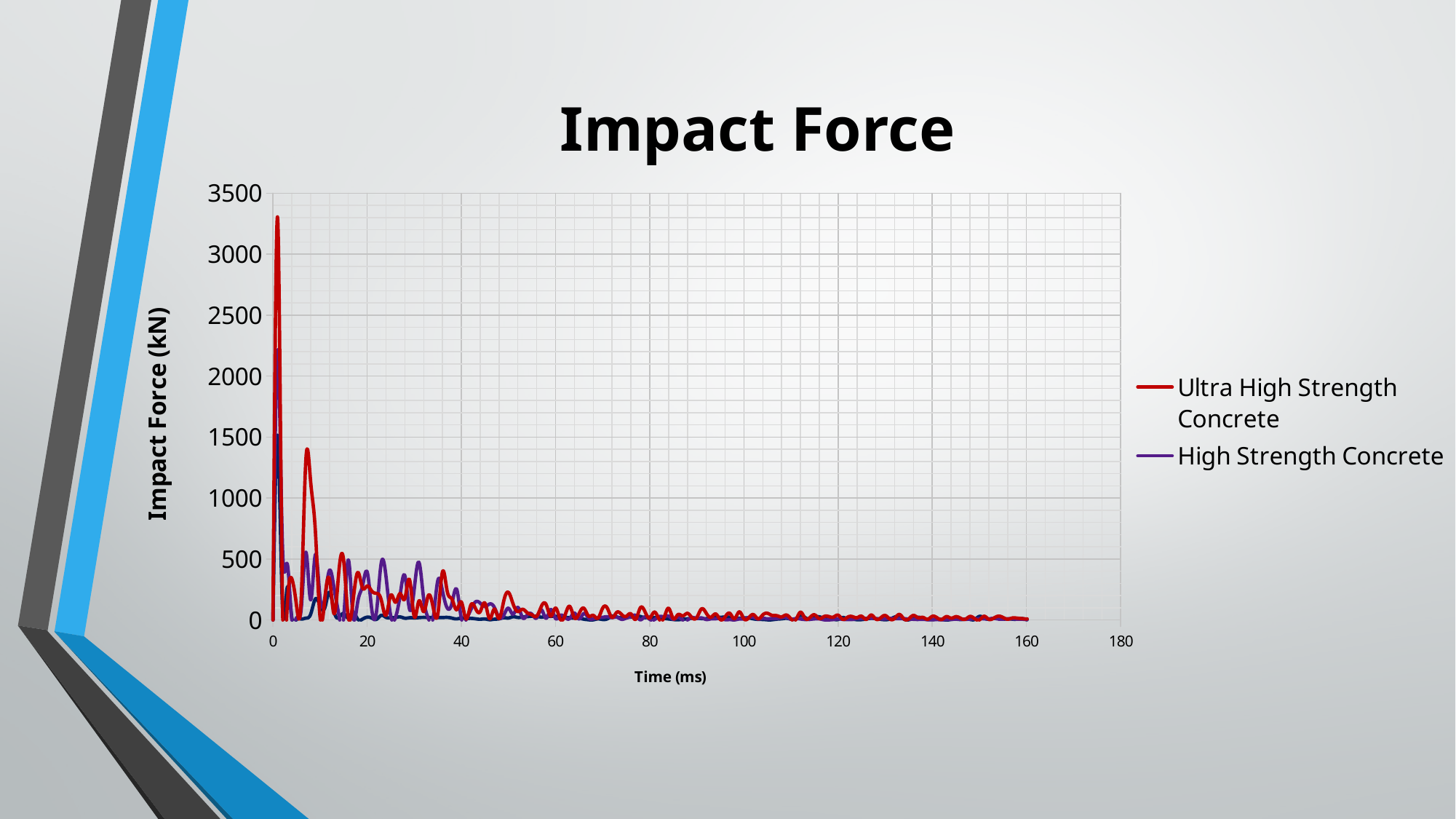
What is the label of the vertical axis? Impact Force (kN) What kind of chart is shown on the slide? line chart Is the peak value of the Ultra High Strength Concrete series greater or less than 3000? greater How many series does the legend list? 2 Which series has the larger peak, Ultra High Strength Concrete or High Strength Concrete? Ultra High Strength Concrete Which series reaches the highest peak impact force? Ultra High Strength Concrete What is the title of the chart? Impact Force Is the peak value of the High Strength Concrete series greater or less than 2500? less What is the highest value shown on the vertical axis? 3500 Overall, do the impact force values rise or fall as time increases along the x axis? fall Is the peak value of the High Strength Concrete series greater or less than 1500? greater